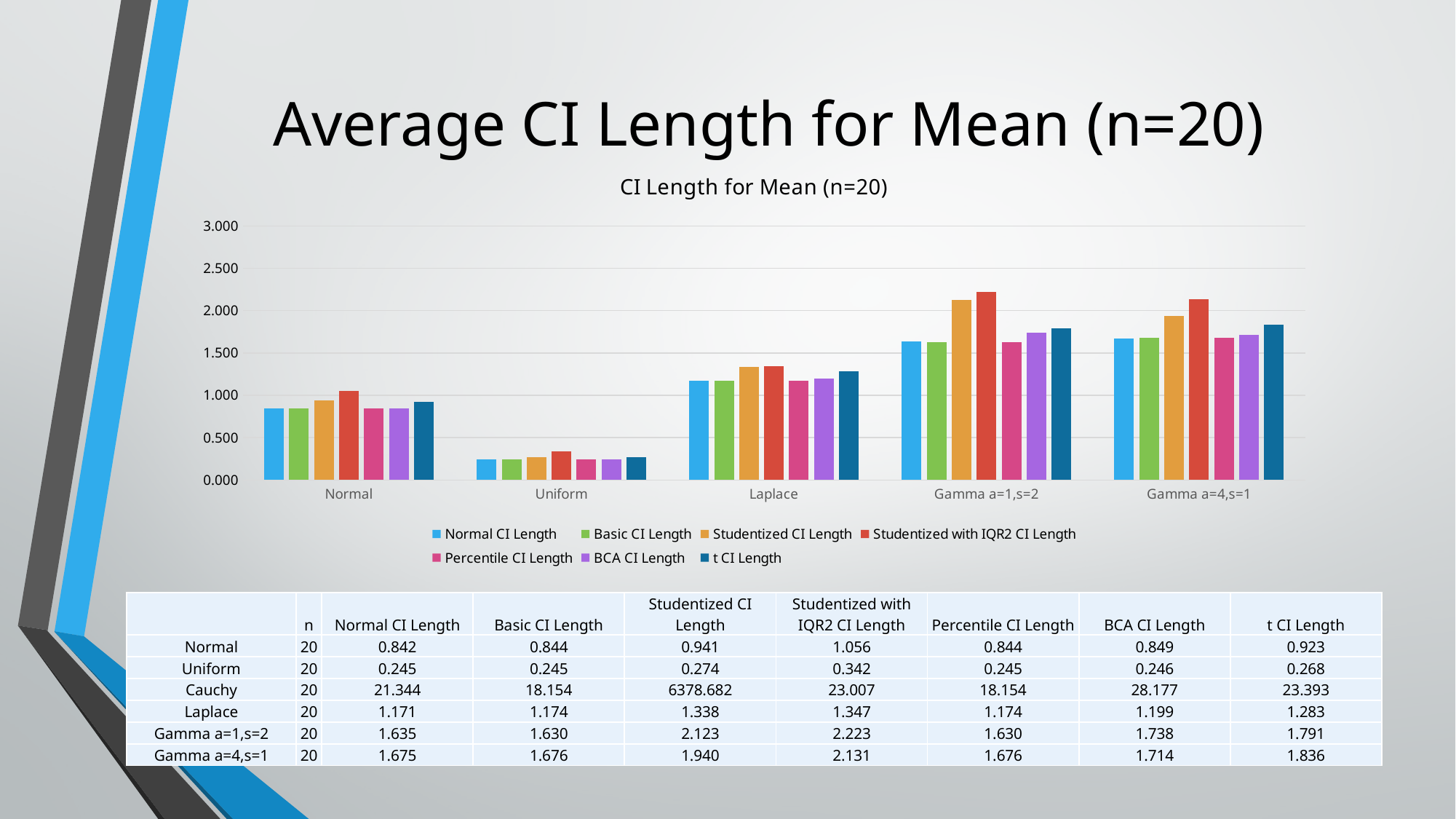
What is the t CI Length for Laplace? 1.283 Is the Studentized CI Length for Gamma a=1,s=2 larger than the Studentized CI Length for Gamma a=4,s=1? Yes What is the Studentized with IQR2 CI Length for Gamma a=1,s=2? 2.223 What is the difference between the Studentized with IQR2 CI Length and the Normal CI Length for Gamma a=1,s=2? 0.588 Which series has the tallest bar for Gamma a=4,s=1? Studentized with IQR2 CI Length How many series does the chart legend list? 7 What colour are the Studentized with IQR2 CI Length bars? red Which category has the lowest CI lengths across all series? Uniform What is the chart title? CI Length for Mean (n=20) What type of chart is shown on the slide? bar chart How many distribution categories are plotted on the x axis of the chart? 5 Is the t CI Length for Laplace greater or less than 1.500? less